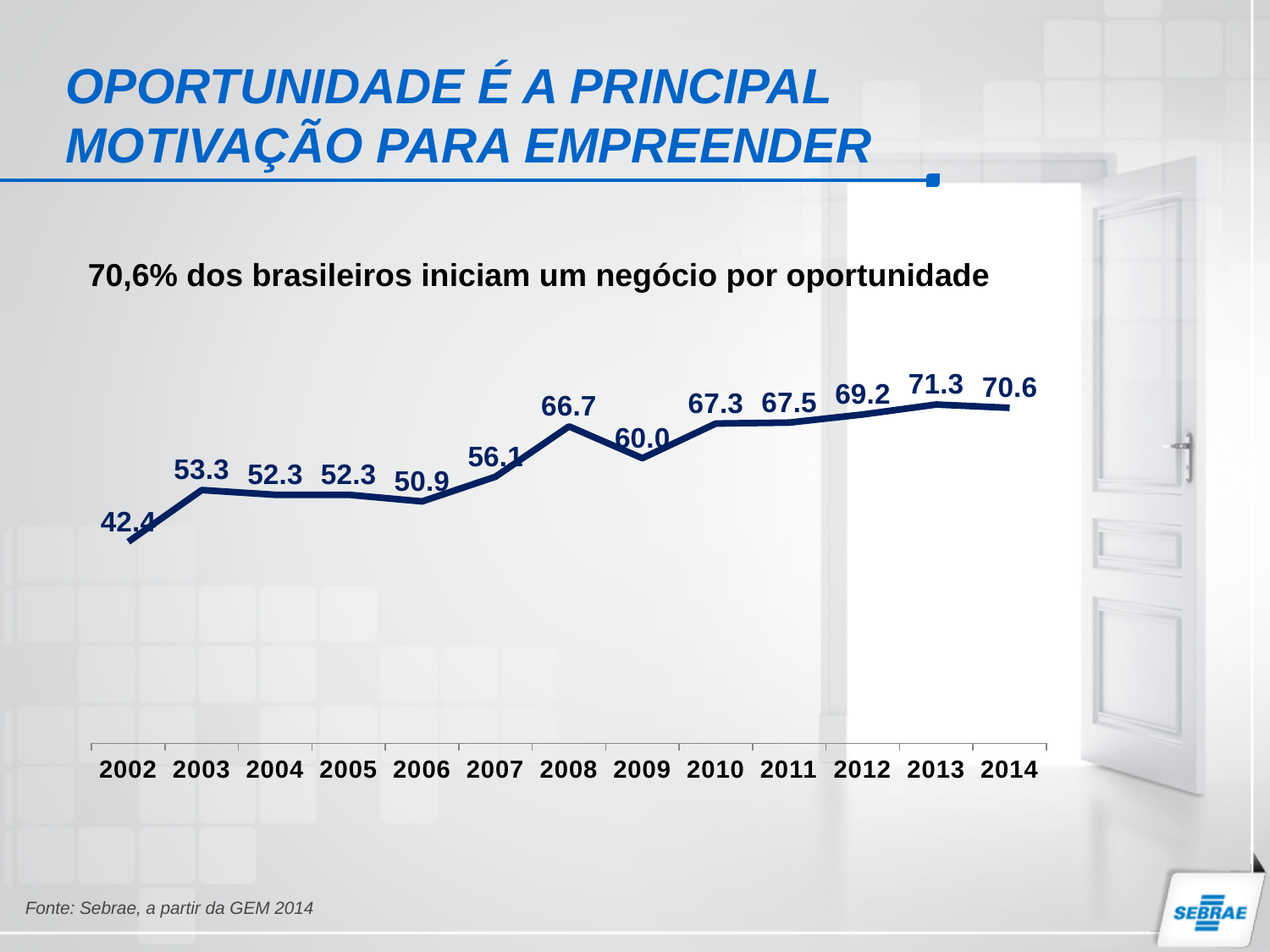
What is the difference between the values for 2008 and 2009? 6.7 What is the value for 2002? 42.4 What is the value for 2008? 66.7 How many years are plotted on the x axis? 13 What is the source cited at the bottom of the slide? Sebrae, a partir da GEM 2014 What kind of chart is shown on the slide? line chart What is the value for 2014? 70.6 Which year has the highest value? 2013 Which year has the lowest value? 2002 What is the difference between the values for 2013 and 2014? 0.7 Do the values generally rise or fall from 2002 to 2014? rise Which is larger, the value for 2008 or the value for 2009? 2008